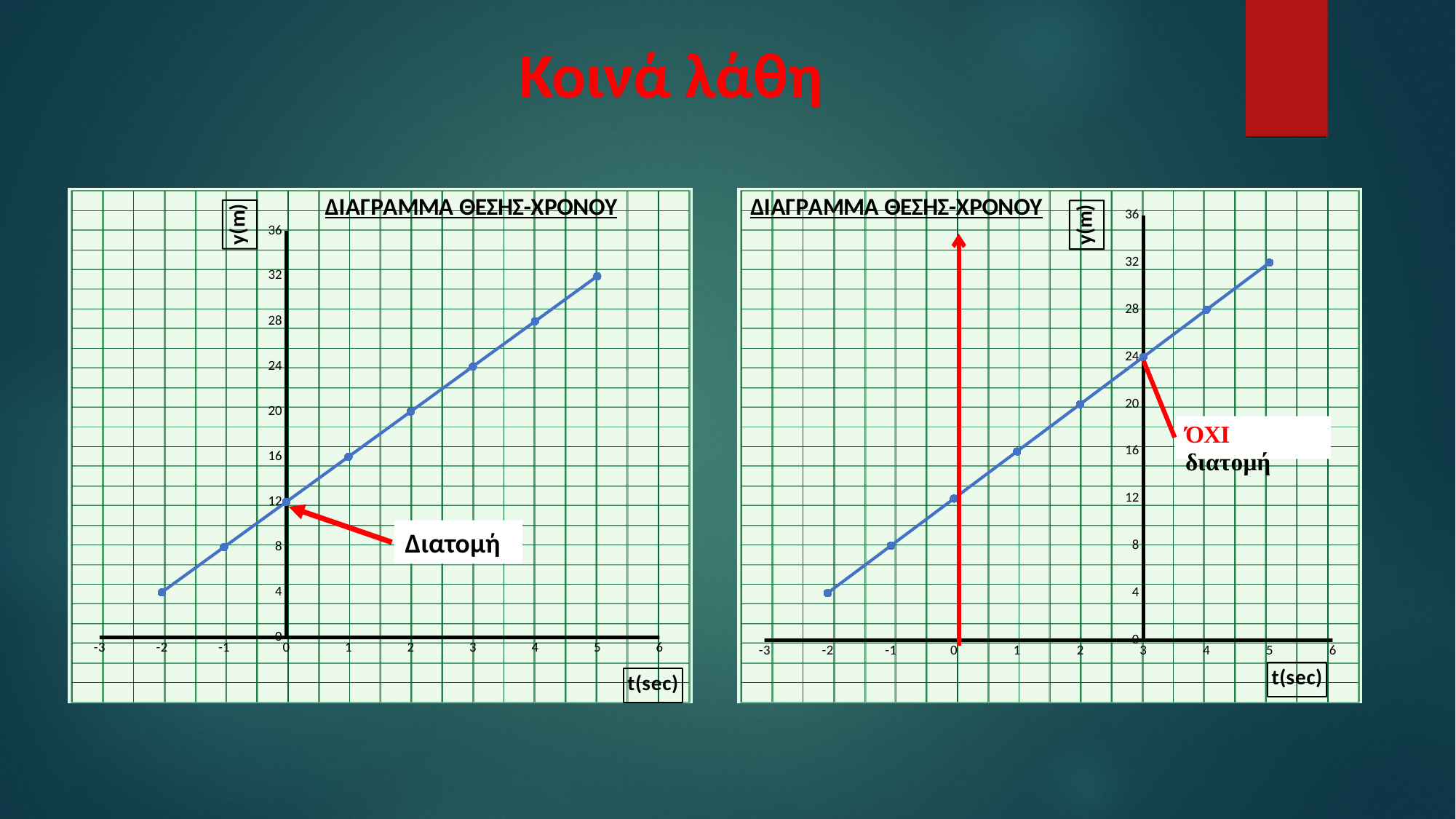
In the left chart, do the y(m) values rise or fall as t increases? rise What kind of chart is the left chart on the slide? line chart In the left chart, at which t value is y(m) highest? 5 In the right chart, what is the value of y(m) at t = -2 sec? 4 In the right chart, which is larger: y(m) at t = 2 sec or y(m) at t = -1 sec? t = 2 sec In the right chart, at which t value is y(m) lowest? -2 In the left chart, what is the value of y(m) at t = 0 sec? 12 In the right chart, what is the value of y(m) at t = 3 sec? 24 In the left chart, what is the value of y(m) at t = 5 sec? 32 What is the label of the horizontal axis in the left chart? t(sec) How many data points are plotted on the line in the right chart? 8 In the left chart, what is the difference between y(m) at t = 4 sec and y(m) at t = 1 sec? 12